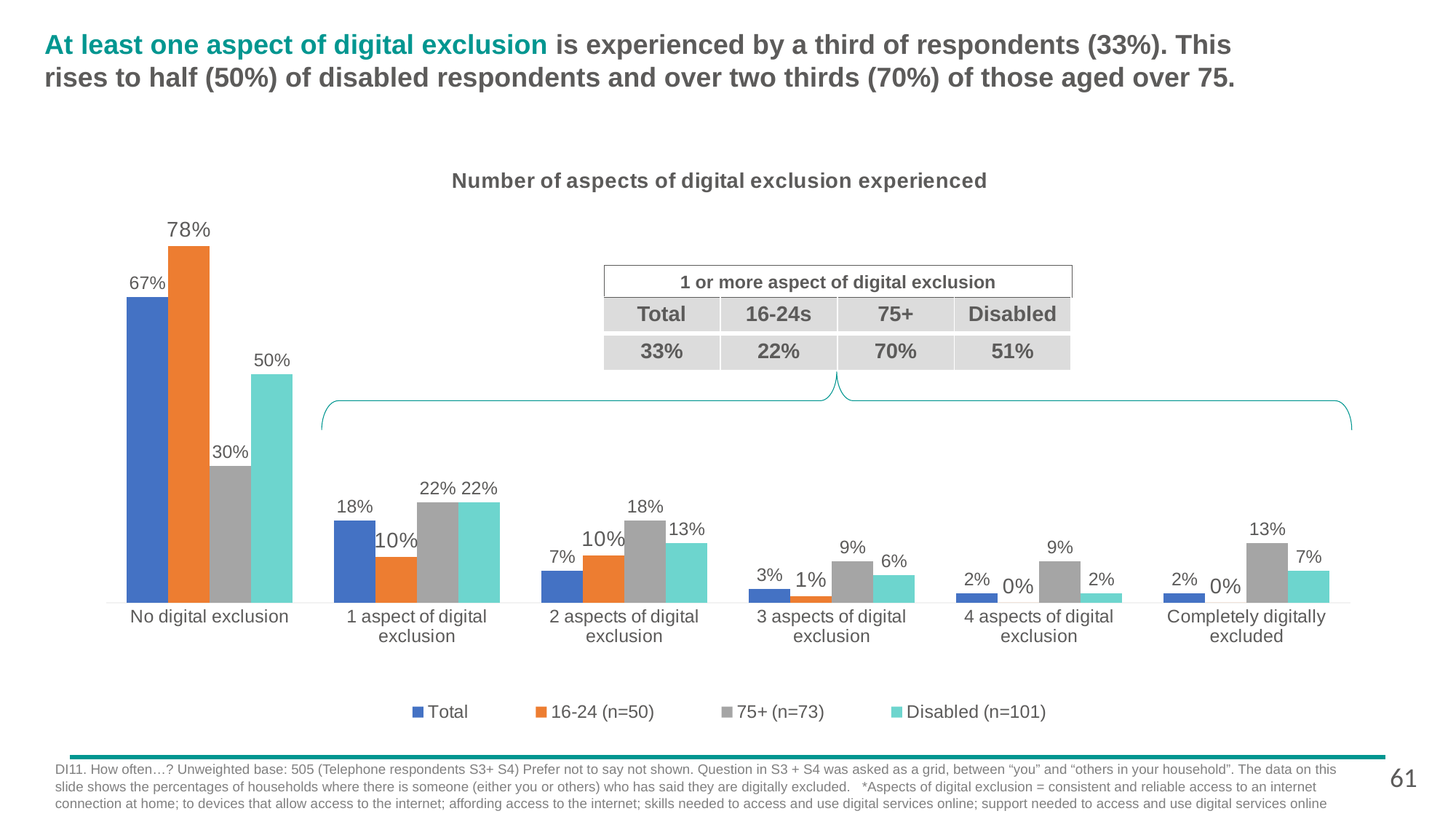
Which is larger in the '1 aspect of digital exclusion' category: Total or 16-24 (n=50)? Total How many series does the legend list? 4 What is the title of the chart? Number of aspects of digital exclusion experienced What type of chart is shown on the slide? Bar chart What is the value for Disabled (n=101) in the '2 aspects of digital exclusion' category? 13% What is the difference between the 16-24 (n=50) and Total values in the 'No digital exclusion' category? 11% What is the value for 75+ (n=73) in the 'Completely digitally excluded' category? 13% Which series has the highest value in the '3 aspects of digital exclusion' category? 75+ (n=73) How many categories are shown along the x axis? 6 According to the table, what percentage of 75+ respondents experience 1 or more aspect of digital exclusion? 70% What is the value for 16-24 (n=50) in the 'No digital exclusion' category? 78% Which series has the lowest value in the 'No digital exclusion' category? 75+ (n=73)